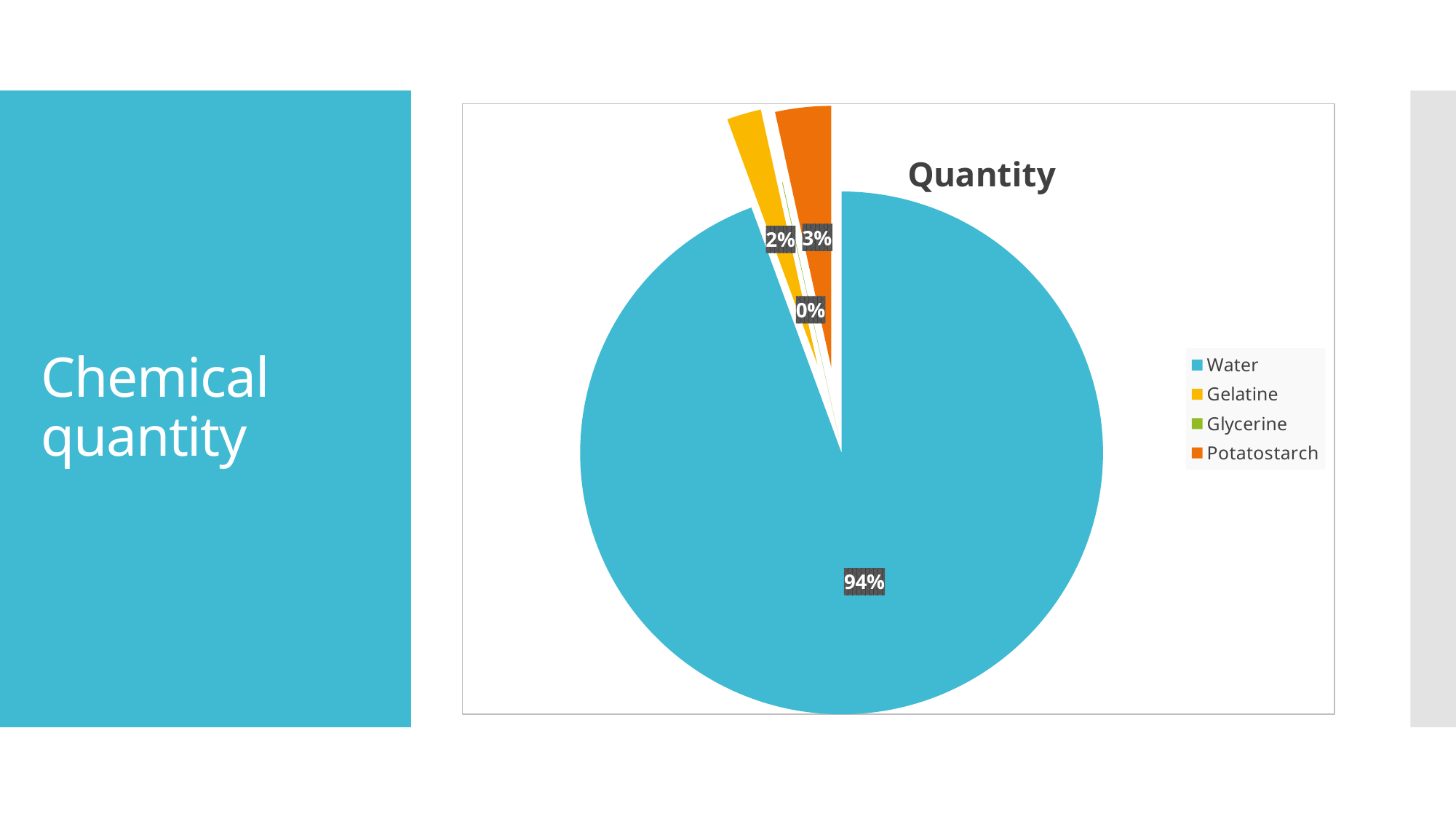
How many categories are shown in the pie chart? 4 What kind of chart is shown on the slide? Pie chart What percentage of the pie does Water account for? 94% What percentage is shown for Gelatine? 2% Which category has the smallest share of the pie? Glycerine Which category has the largest share of the pie? Water What is the difference in percentage points between Water and Potatostarch? 91% What percentage is shown for Potatostarch? 3% What percentage is shown for Glycerine? 0% What colour represents Water in the pie chart? Blue Which has a larger share, Potatostarch or Gelatine? Potatostarch What is the title of the chart? Quantity